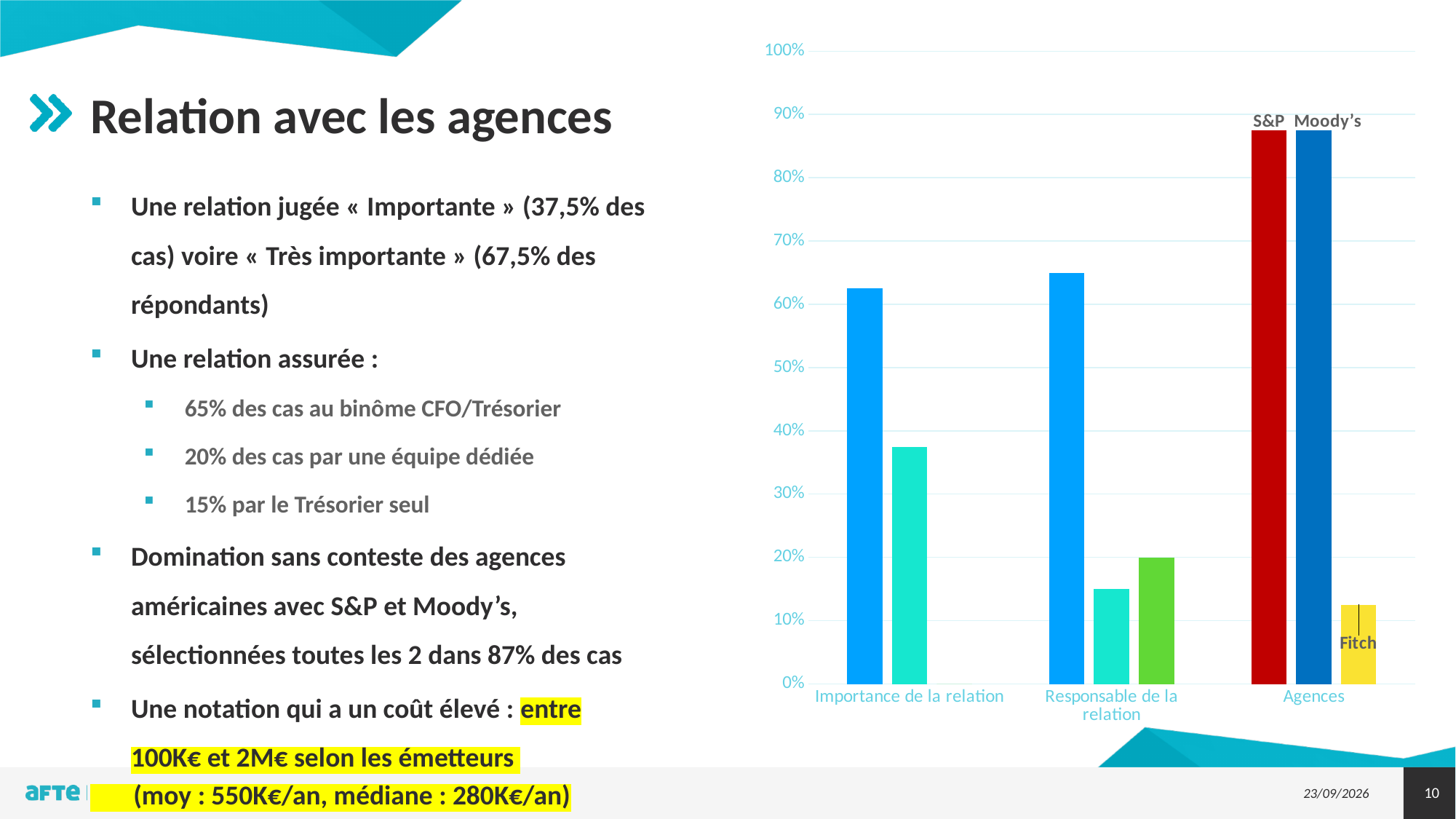
Is the value of the second bar in 'Importance de la relation' greater or less than 40%? less Is the value for S&P in the 'Agences' category greater or less than 80%? greater How many categories are shown on the x axis of the chart? 3 Which is larger in the 'Agences' category, the bar for S&P or the bar for Fitch? S&P How many bars are plotted in the 'Responsable de la relation' category? 3 Is the value of the first (tallest) bar in 'Importance de la relation' greater or less than 60%? greater In the 'Agences' category, which agency has the lowest bar? Fitch Which three agencies are labelled on the bars in the 'Agences' category? S&P, Moody's, Fitch What is the highest value shown on the chart's vertical axis? 100% What kind of chart is shown on the slide? bar chart